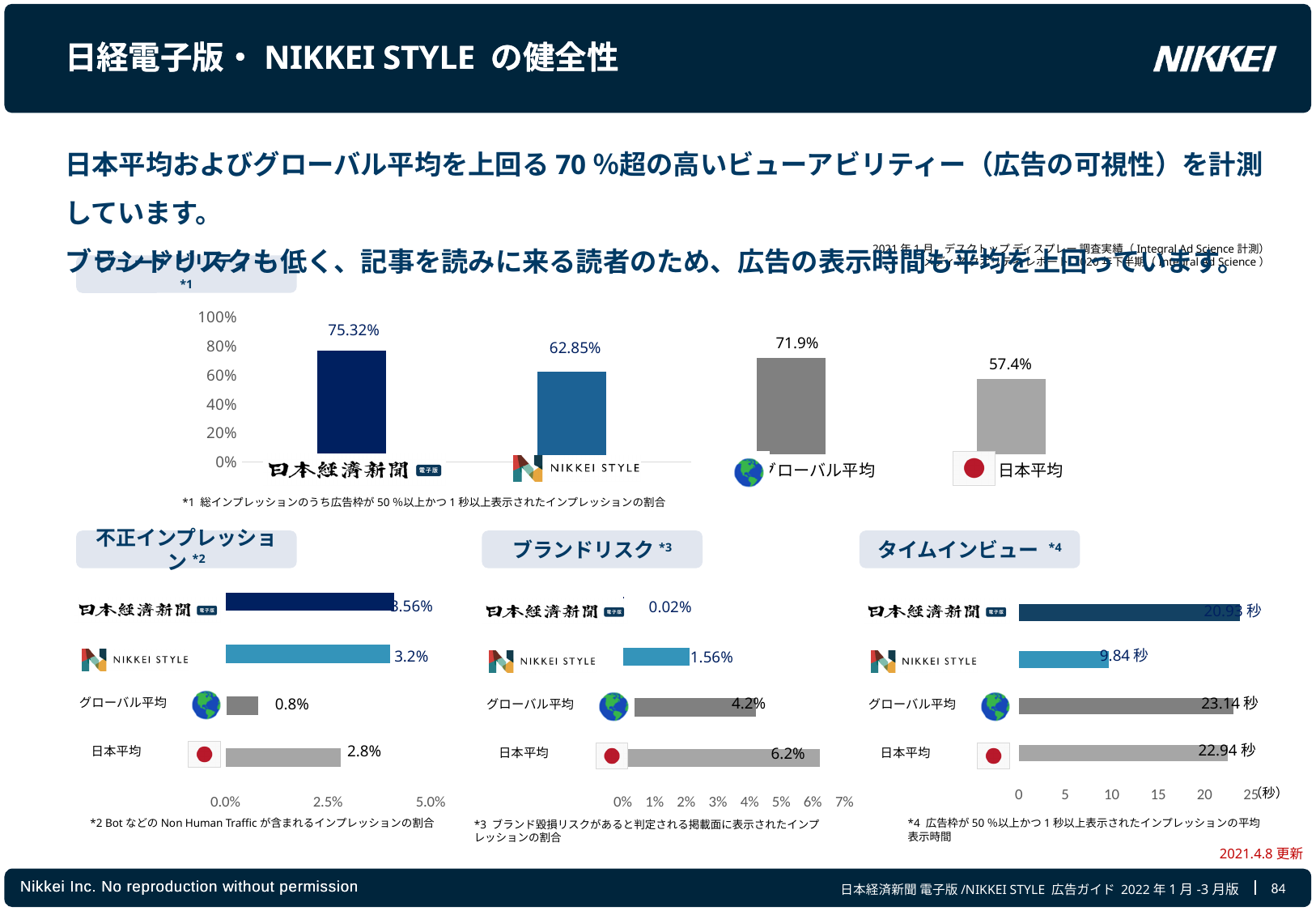
In the タイムインビュー chart, what is the value for NIKKEI STYLE? 9.84 秒 What kind of chart is the タイムインビュー chart? bar chart In the ブランドリスク chart, what is the difference between 日本平均 and グローバル平均? 2.0% In the ブランドリスク chart, what is the value for NIKKEI STYLE? 1.56% In the top chart, how many bars are plotted? 4 In the 不正インプレッション chart, what is the value for グローバル平均? 0.8% In the ブランドリスク chart, which is larger, グローバル平均 or 日本平均? 日本平均 In the top chart, which category has the lowest value? 日本平均 In the 不正インプレッション chart, which category has the highest value? 日本経済新聞 In the タイムインビュー chart, which category has the highest value? グローバル平均 In the top chart, what is the difference between 日本経済新聞 and 日本平均? 17.92% In the top chart, what is the value for 日本経済新聞? 75.32%